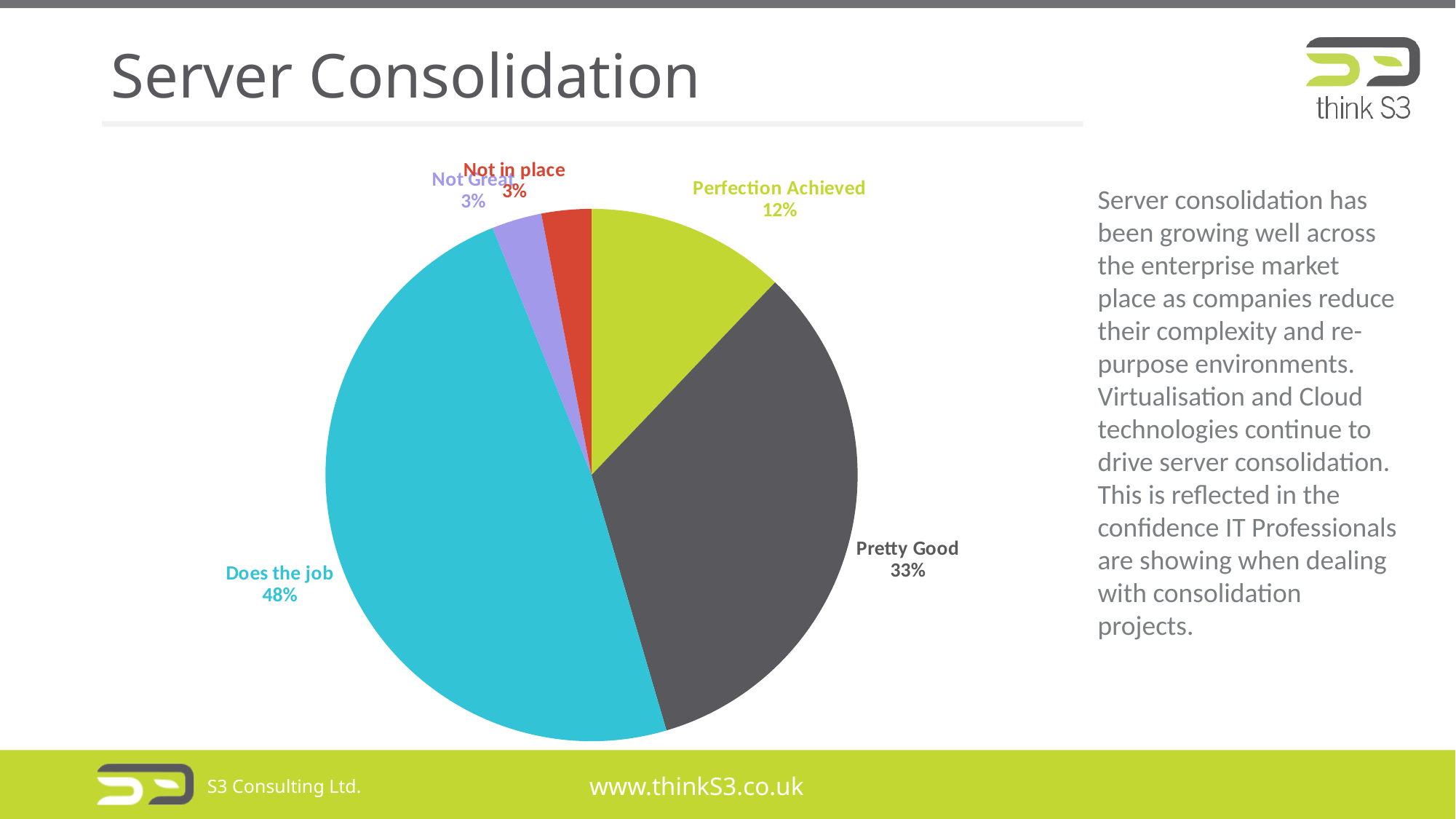
What share of the pie does "Does the job" represent? 48% What share of the pie does "Pretty Good" represent? 33% What is the difference in percentage points between "Does the job" and "Pretty Good"? 15% What is the combined share of "Pretty Good" and "Perfection Achieved"? 45% What colour is the "Does the job" slice? cyan (light blue) Which category has the largest slice of the pie? Does the job How many slices does the pie chart have? 5 What share of the pie does "Perfection Achieved" represent? 12% Which is larger, the slice for "Pretty Good" or the slice for "Perfection Achieved"? Pretty Good What kind of chart is shown on the slide? pie chart